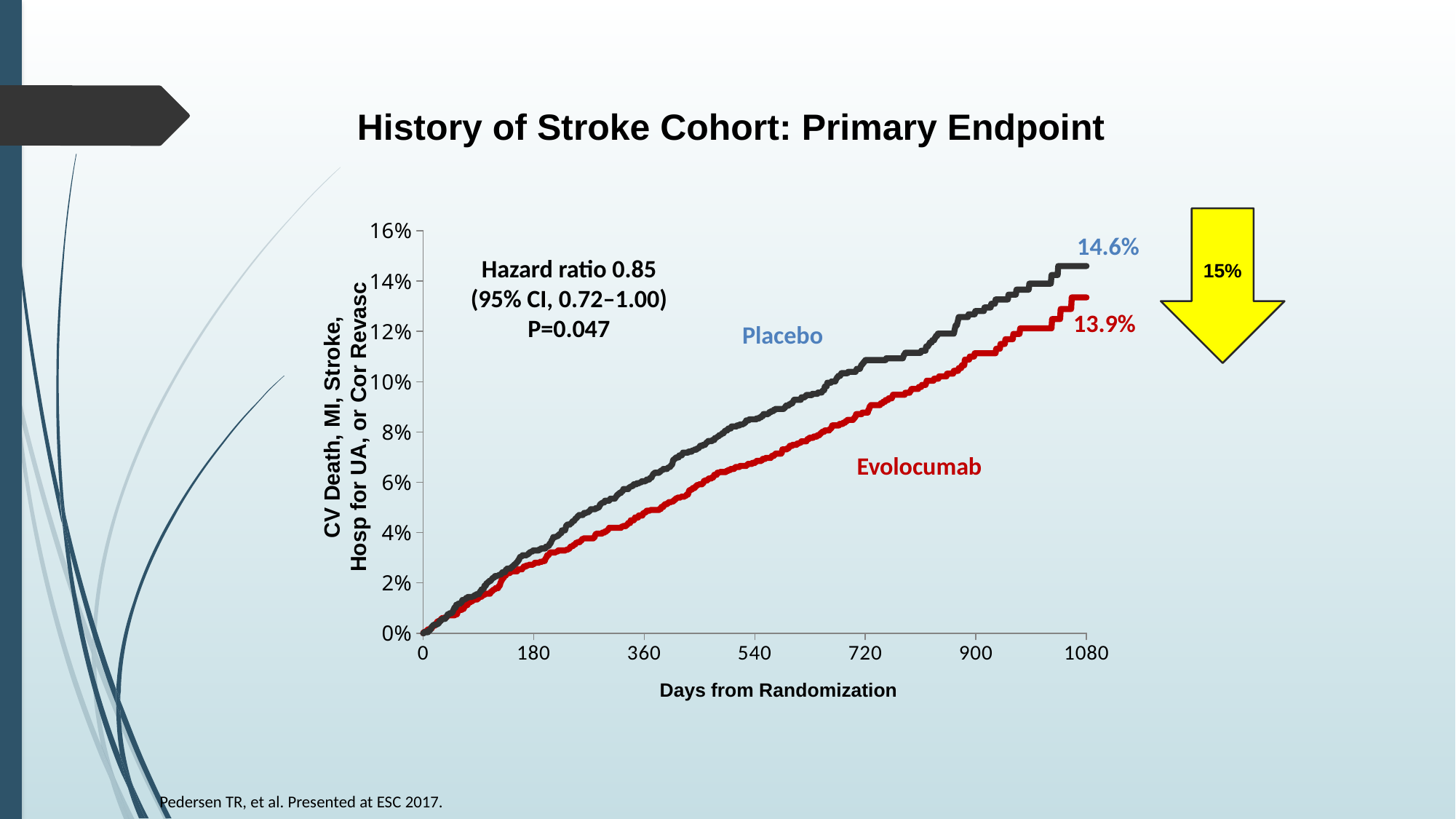
What kind of chart is shown on the slide? Line chart Do the event rates rise or fall as days from randomization increase? Rise What hazard ratio is reported on the chart? 0.85 What is the final event rate shown for the Placebo group? 14.6% What is the difference between the final Placebo and Evolocumab event rates? 0.7% What is the label of the x axis? Days from Randomization What percentage is shown inside the yellow arrow? 15% Is the Evolocumab event rate at day 900 greater or less than 8%? greater Is the Placebo event rate at day 540 greater or less than 10%? less How many treatment groups (series) are plotted on the chart? 2 What is the final event rate shown for the Evolocumab group? 13.9% Which group has the higher event rate at the end of follow-up, Placebo or Evolocumab? Placebo